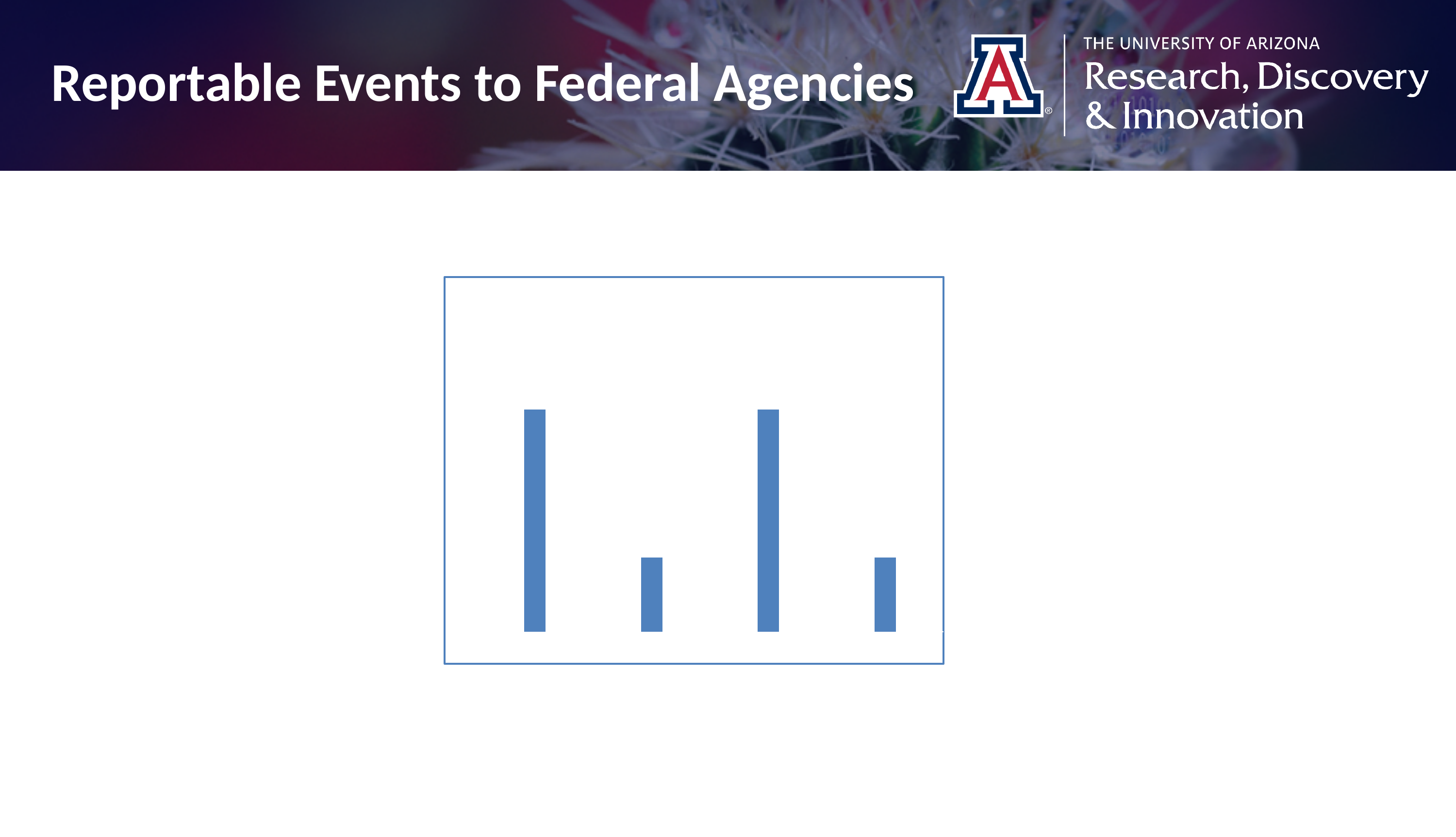
Which bar is taller, the third bar from the left or the fourth bar from the left? the third bar from the left What kind of chart is shown on the slide? bar chart Which bar is taller, the first bar from the left or the second bar from the left? the first bar from the left What colour are the bars in the chart? blue How many bars does the chart on the slide contain? 4 Which bar is shorter, the second bar from the left or the third bar from the left? the second bar from the left Does the chart on the slide display any axis labels or data labels? no